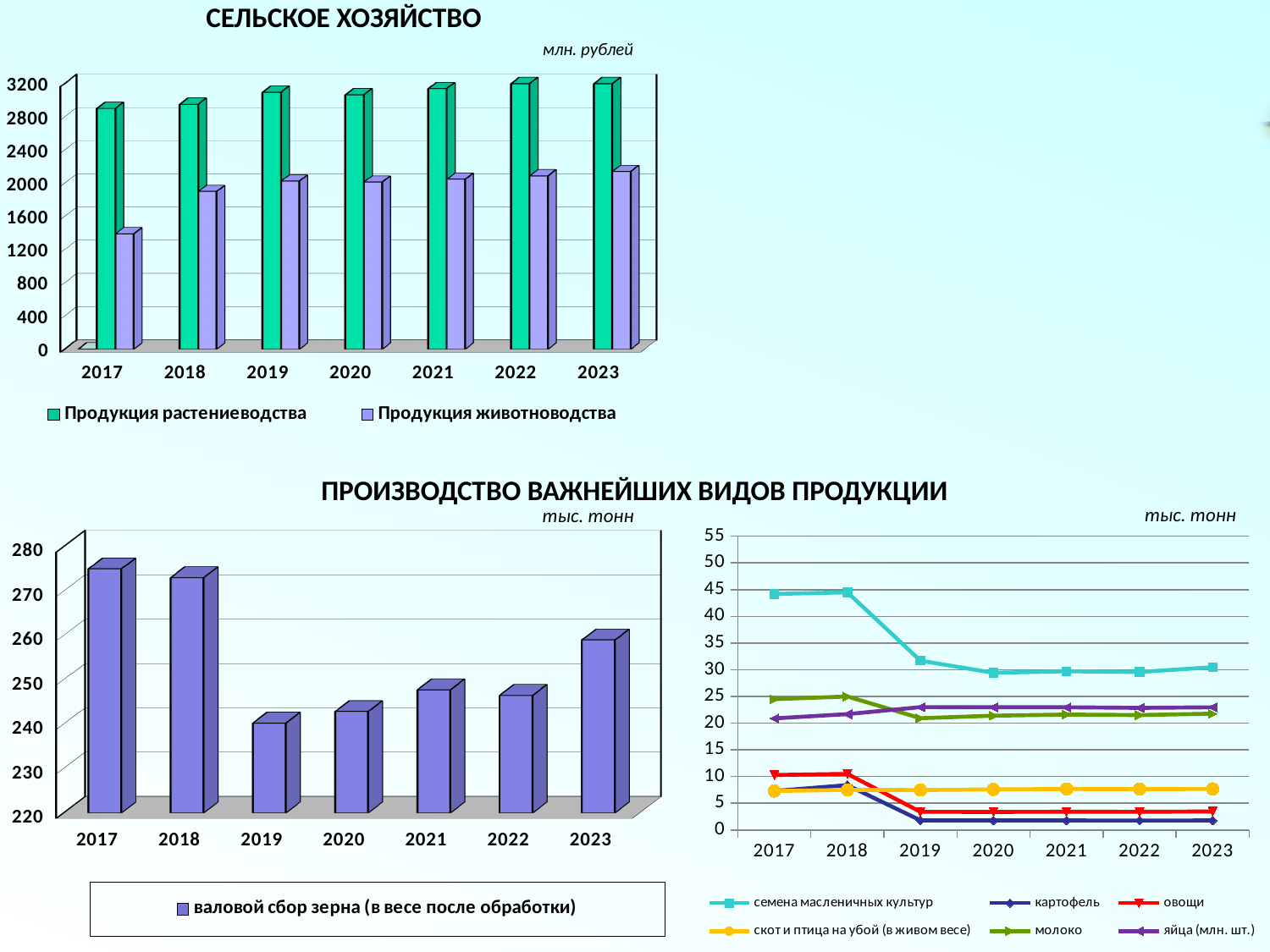
In the bottom-right line chart, how many series does the legend list? 6 In the bottom-left chart («валовой сбор зерна»), which year has the lowest value? 2019 In the bottom-right line chart, is the value for «семена масленичных культур» in 2017 greater or less than 40? greater In the chart titled «СЕЛЬСКОЕ ХОЗЯЙСТВО», is the value for «Продукция животноводства» in 2017 greater or less than 1600? less In the chart titled «СЕЛЬСКОЕ ХОЗЯЙСТВО», how many series does the legend list? 2 In the bottom-left chart («валовой сбор зерна»), is the value for 2023 greater or less than 250? greater In the chart titled «СЕЛЬСКОЕ ХОЗЯЙСТВО», what kind of chart is it? bar chart In the bottom-left chart («валовой сбор зерна»), how many years are shown on the x axis? 7 In the bottom-left chart («валовой сбор зерна»), which year has the highest value? 2017 In the chart titled «СЕЛЬСКОЕ ХОЗЯЙСТВО», does the value for «Продукция животноводства» rise or fall from 2017 to 2023? rise In the chart titled «СЕЛЬСКОЕ ХОЗЯЙСТВО», which series has the larger value in 2020, «Продукция растениеводства» or «Продукция животноводства»? Продукция растениеводства